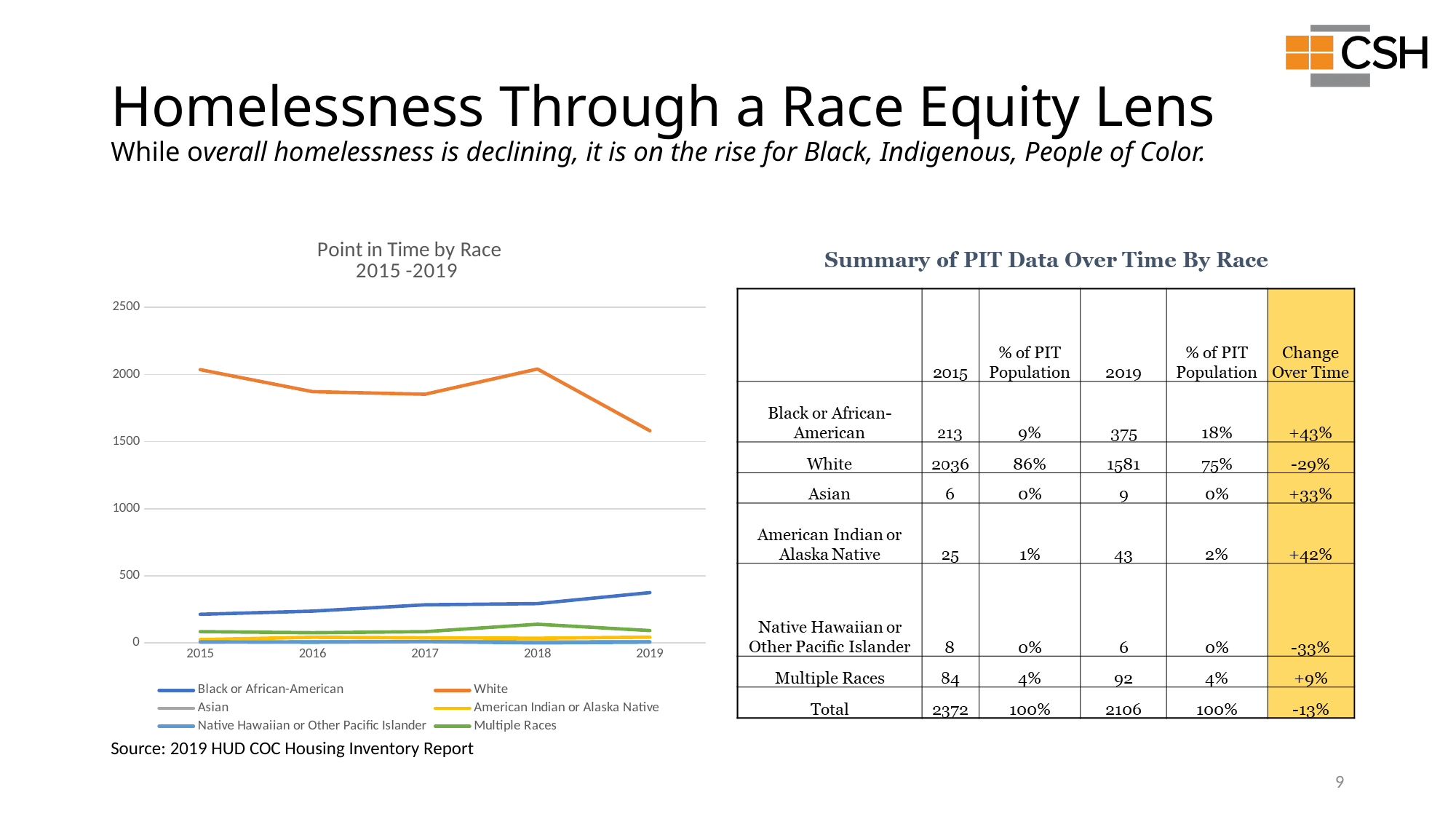
What kind of chart is shown on the slide? line chart How many series does the legend of the 'Point in Time by Race' chart list? 6 What is the title of the line chart on the slide? Point in Time by Race 2015 -2019 In the 'Point in Time by Race' chart, is the value for White in 2019 greater or less than 2000? less In the 'Point in Time by Race' chart, is the value for Black or African-American in 2019 greater or less than 500? less In the 'Point in Time by Race' chart, does the Black or African-American line rise or fall from 2015 to 2019? rise In the 'Point in Time by Race' chart, which is larger in 2019: the value for White or the value for Black or African-American? White In the 'Point in Time by Race' chart, does the White line rise or fall from 2018 to 2019? fall In the 'Point in Time by Race' chart, is the value for White in 2019 greater or less than 1500? greater How many years are plotted along the x axis of the 'Point in Time by Race' chart? 5 Which series has the highest values in the 'Point in Time by Race' chart? White